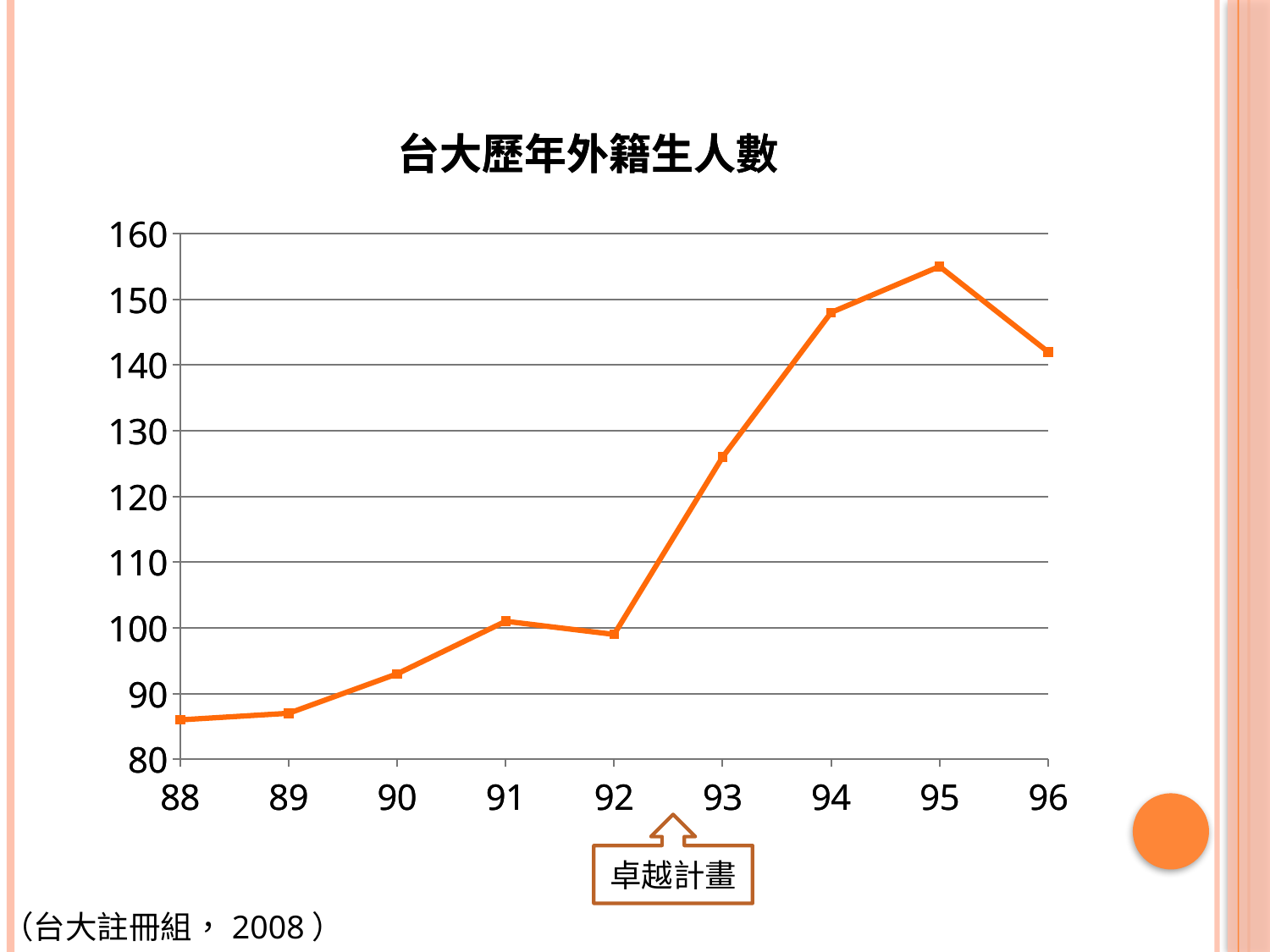
Which year has the highest number of foreign students? 95 What kind of chart is shown on the slide? line chart Is the value for year 93 greater or less than 120? greater Which is larger, the value for year 94 or the value for year 93? 94 Is the value for year 95 greater or less than 150? greater Does the number of foreign students rise or fall from year 92 to year 95? rise What is the title of the chart? 台大歷年外籍生人數 What label is shown in the annotation box below the x axis between years 92 and 93? 卓越計畫 Is the value for year 88 greater or less than 90? less How many data points are plotted on the line? 9